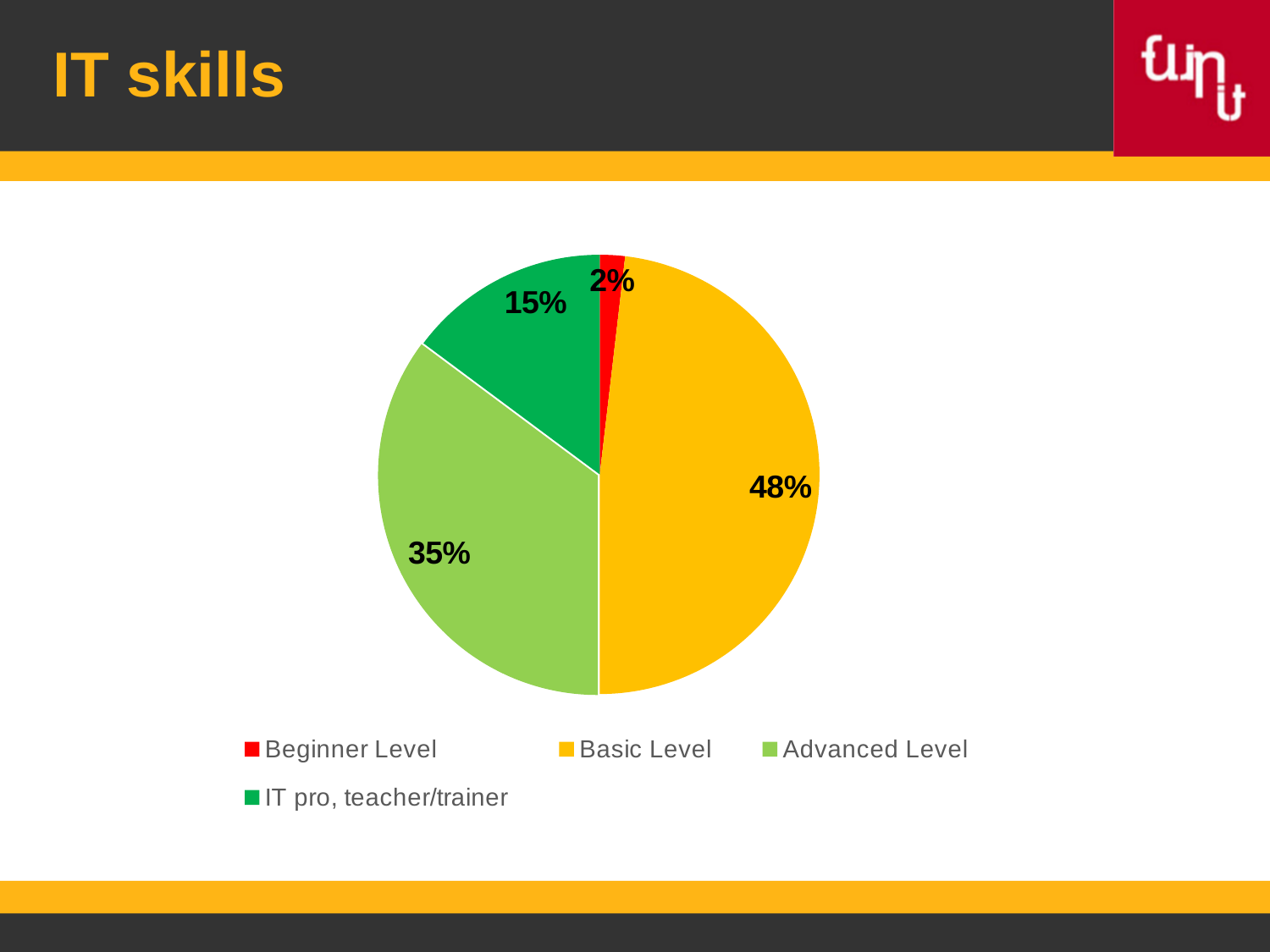
How many categories does the pie chart have? 4 Which category has the smallest share of the pie? Beginner Level What share of the pie is IT pro, teacher/trainer? 15% What share of the pie is Basic Level? 48% What colour is the Beginner Level slice? red Which category has the largest share of the pie? Basic Level Which is larger, the share for Advanced Level or the share for IT pro, teacher/trainer? Advanced Level What is the difference in percentage points between Basic Level and Advanced Level? 13 What share of the pie is Advanced Level? 35% What kind of chart is shown on the slide? pie chart What is the title of the slide containing the chart? IT skills